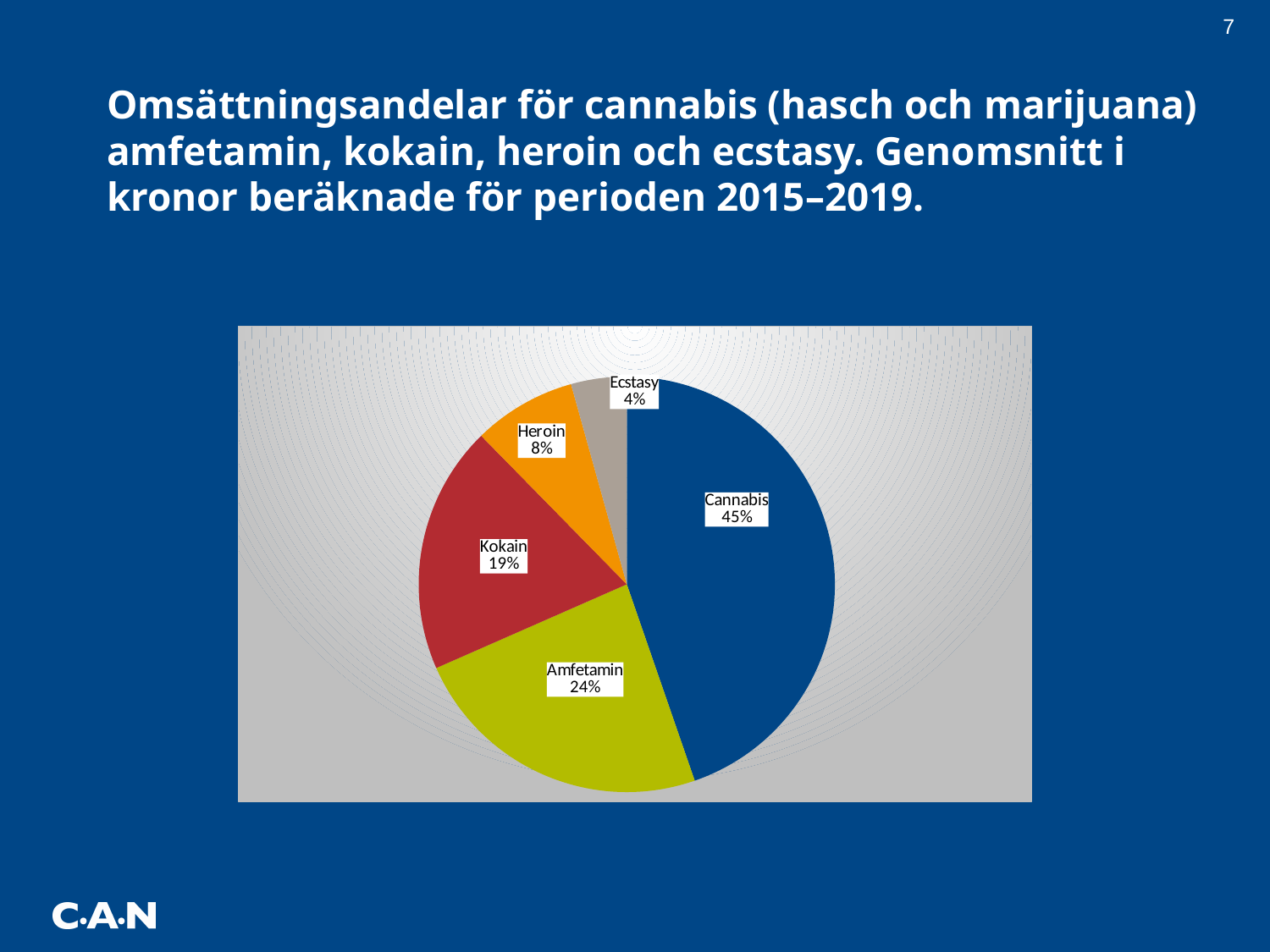
Which category has the smallest slice of the pie? Ecstasy What is the difference in percentage points between Cannabis and Amfetamin? 21 Which category has the largest slice of the pie? Cannabis Which is larger, the share for Kokain or the share for Heroin? Kokain How many slices does the pie chart have? 5 What colour is the Kokain slice? red What is the value shown for Amfetamin? 24% What is the value shown for Ecstasy? 4% What is the value shown for Heroin? 8% What kind of chart is shown on the slide? pie chart What is the value shown for Kokain? 19% What share of the pie does Cannabis account for? 45%